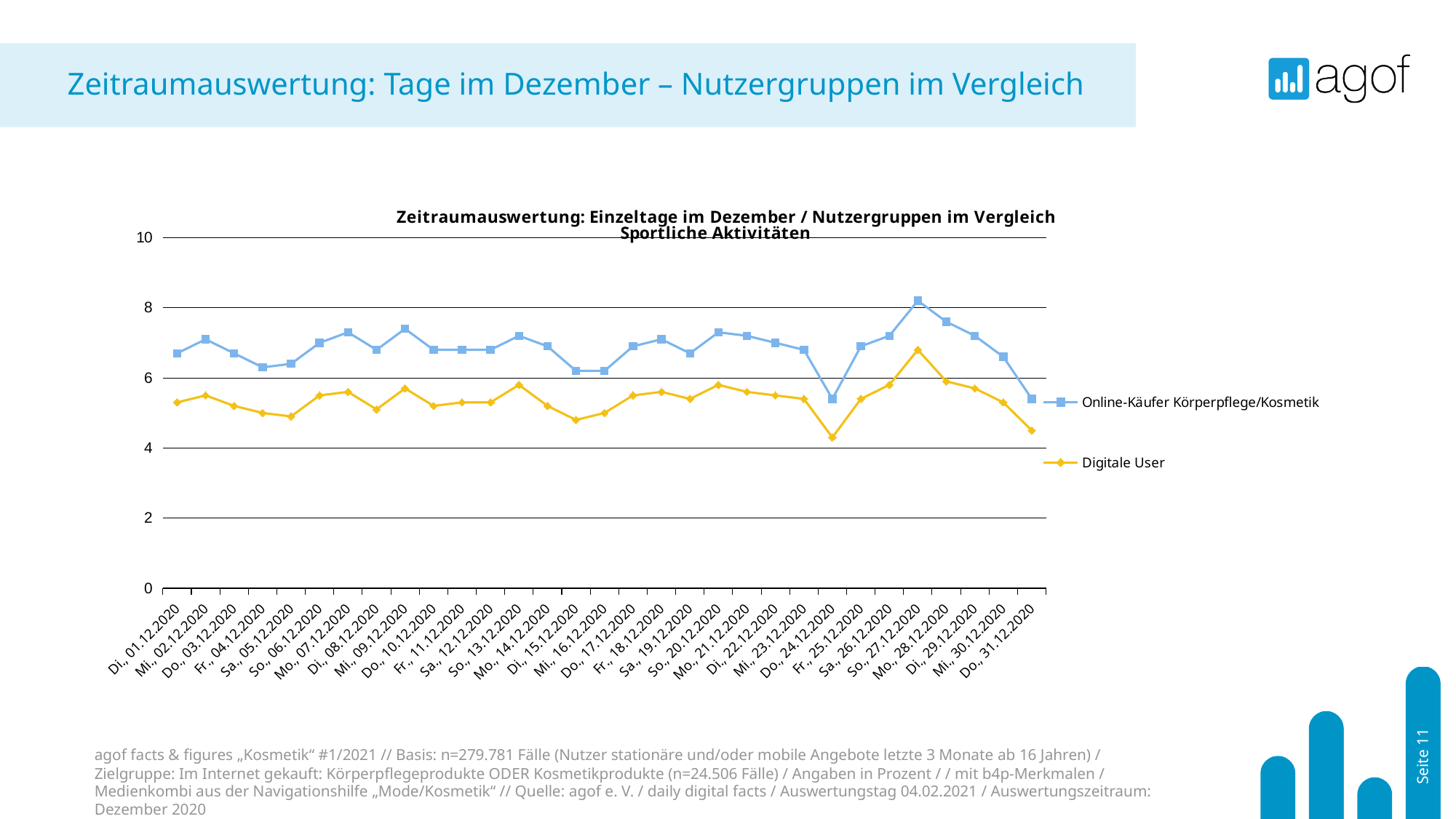
Is the value for Online-Käufer Körperpflege/Kosmetik on Fr., 25.12.2020 greater or less than 6? greater How many days (data points) are plotted along the x axis? 31 Which colour is used for the Digitale User series? yellow Is the value for Digitale User on Fr., 25.12.2020 greater or less than 6? less Do the values of the Digitale User series rise or fall from Mo., 28.12.2020 to Do., 31.12.2020? fall How many series does the legend list? 2 On which day does the Online-Käufer Körperpflege/Kosmetik series reach its highest value? So., 27.12.2020 Which series has the higher value on Di., 01.12.2020, Online-Käufer Körperpflege/Kosmetik or Digitale User? Online-Käufer Körperpflege/Kosmetik Is the value for Online-Käufer Körperpflege/Kosmetik on Mo., 28.12.2020 greater or less than 8? less What kind of chart is shown on the slide? line chart On which day does the Digitale User series reach its highest value? So., 27.12.2020 What is the subtitle (second line) of the chart title? Sportliche Aktivitäten